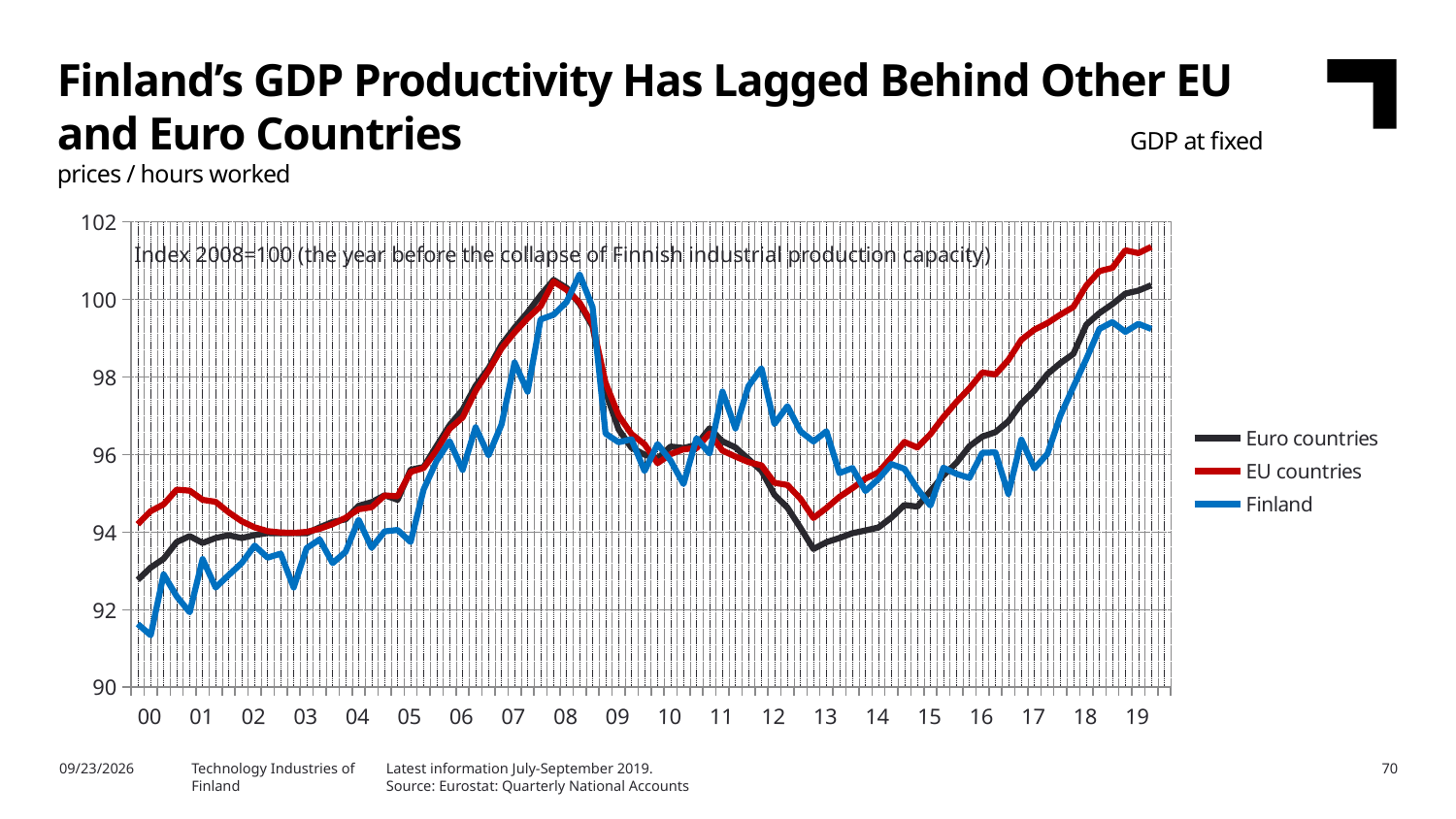
How many series does the legend list? 3 Does the Finland series rise or fall between 2013 and 2018? Rise Is the value for EU countries at the end of the series in 2019 greater or less than 100? greater Is the value for Finland at the start of 2000 greater or less than 92? less At the end of the series in 2019, which is higher: EU countries or Finland? EU countries At the start of 2000, which is higher: Euro countries or Finland? Euro countries Which series is drawn in blue? Finland How many year labels are shown on the x axis? 20 What kind of chart is shown on the slide? Line chart What base year is the index set to 100, according to the note on the chart? 2008 Is the value for Finland at the end of the series in 2019 greater or less than 100? less